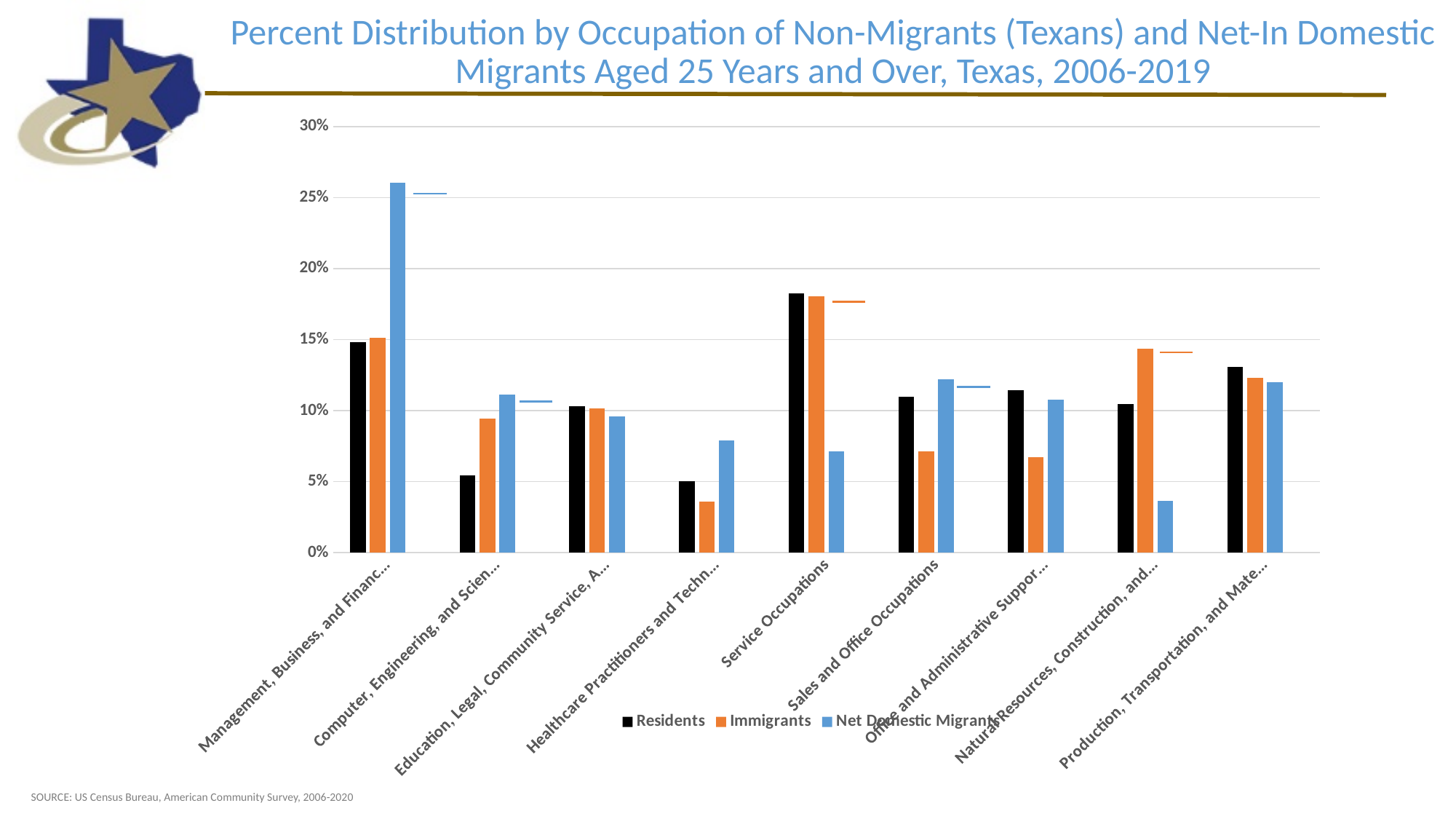
What source is cited at the bottom of the slide? US Census Bureau, American Community Survey, 2006-2020 Is the Residents value for Service Occupations greater or less than 15%? greater Which occupation category has the highest value for Residents? Service Occupations For Service Occupations, which series has the lowest value? Net Domestic Migrants How many occupation categories are plotted along the x axis? 9 Is the Net Domestic Migrants value for Service Occupations greater or less than 10%? less What kind of chart is shown on the slide? bar chart Is the Immigrants value for Sales and Office Occupations greater or less than 10%? less Which colour represents the Immigrants series in the legend? orange For Sales and Office Occupations, which is larger: the Immigrants value or the Net Domestic Migrants value? Net Domestic Migrants How many series does the legend list? 3